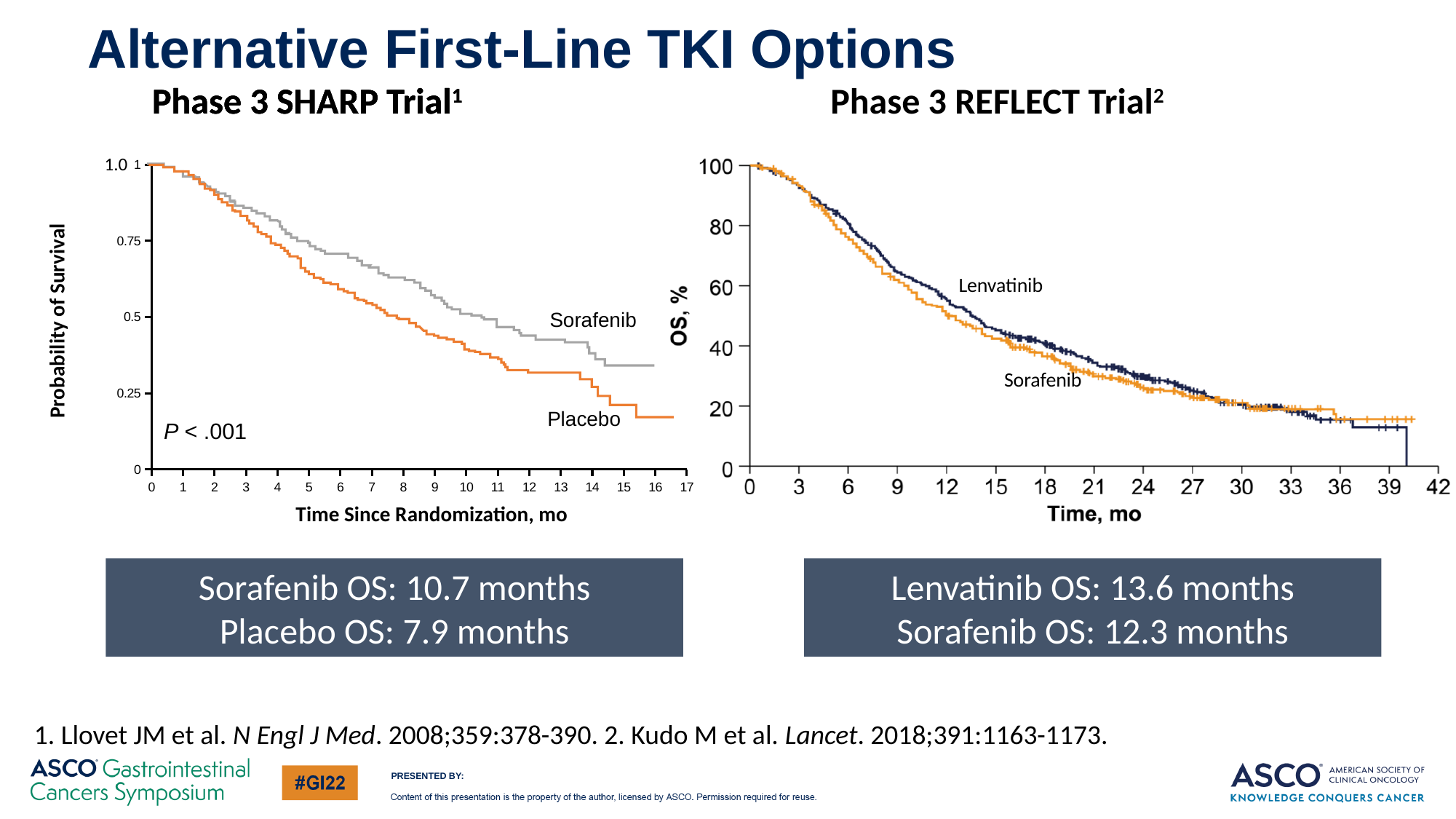
According to the text box under the Phase 3 SHARP Trial chart, what is the Placebo OS? 7.9 months On the Phase 3 SHARP Trial chart, is the Sorafenib probability of survival at 8 months greater or less than 0.5? greater According to the text box under the Phase 3 SHARP Trial chart, what is the Sorafenib OS? 10.7 months On the Phase 3 REFLECT Trial chart, is the Sorafenib OS at 24 months greater or less than 40%? less How many treatment arms (curves) are plotted on the Phase 3 REFLECT Trial chart? 2 What P value is printed on the Phase 3 SHARP Trial chart? P < .001 On the Phase 3 SHARP Trial chart, do the survival curves rise or fall as time since randomization increases? fall According to the text box under the Phase 3 REFLECT Trial chart, what is the Lenvatinib OS? 13.6 months In the Phase 3 SHARP Trial, what is the difference between the Sorafenib OS and the Placebo OS shown in the text box? 2.8 months On the Phase 3 SHARP Trial chart, which curve is higher at 9 months, Sorafenib or Placebo? Sorafenib What kind of chart is the Phase 3 SHARP Trial chart? line chart In the Phase 3 REFLECT Trial, what is the difference between the Lenvatinib OS and the Sorafenib OS shown in the text box? 1.3 months